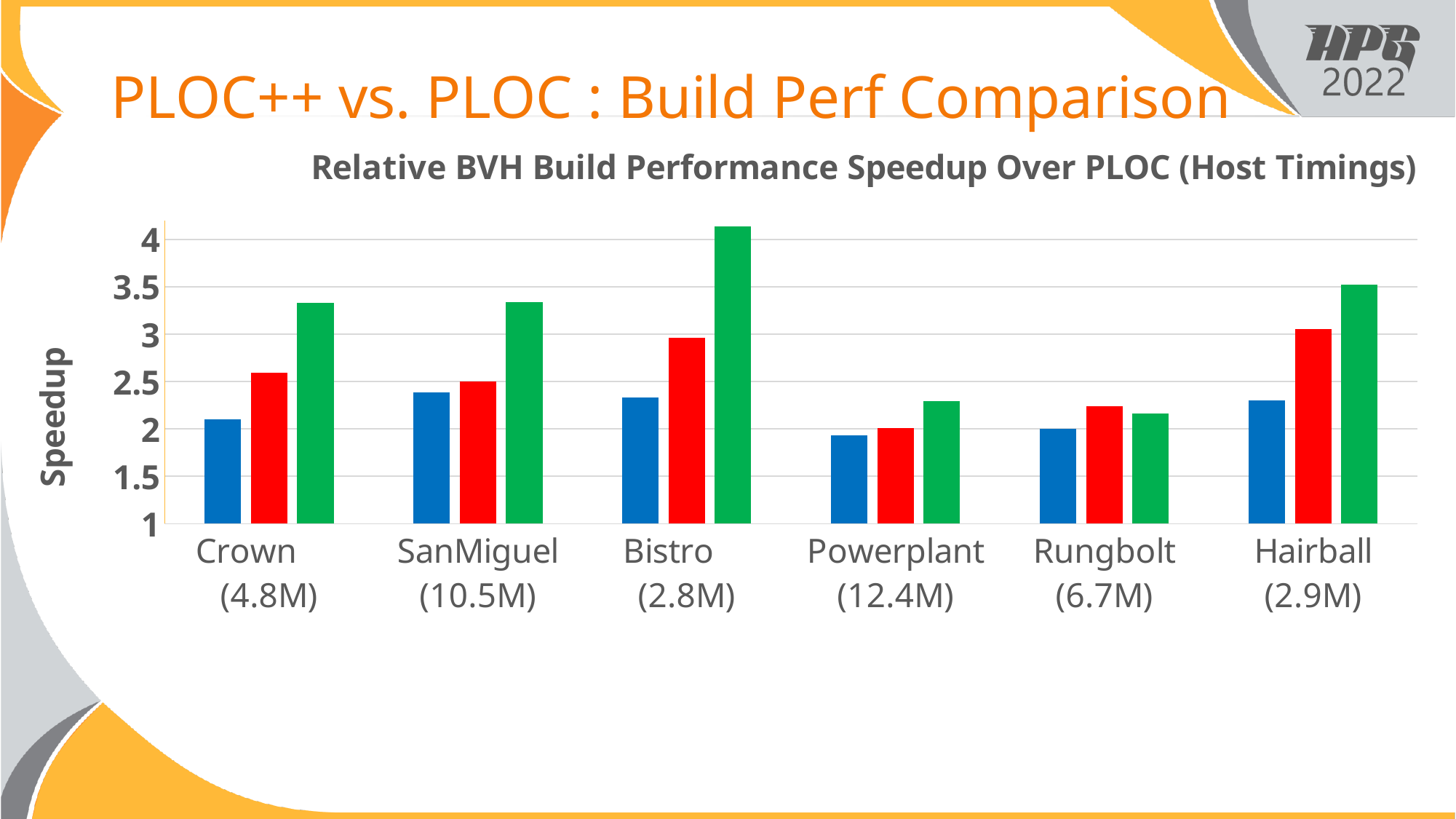
Is the red bar for Hairball (2.9M) greater or less than 3? greater Is the green bar for Rungbolt (6.7M) greater or less than 2.5? less Which scene has the tallest bar overall in the chart? Bistro (2.8M) Which is larger: the green bar for Hairball (2.9M) or the green bar for Powerplant (12.4M)? Hairball (2.9M) Is the green bar for Bistro (2.8M) greater or less than 4? greater How many bars (series) are plotted for each scene category? 3 What kind of chart is shown on the slide? Bar chart What is the title of the chart? Relative BVH Build Performance Speedup Over PLOC (Host Timings) For Crown (4.8M), which is larger: the blue bar or the green bar? The green bar What is the label on the vertical axis of the chart? Speedup How many scene categories are shown on the x axis of the chart? 6